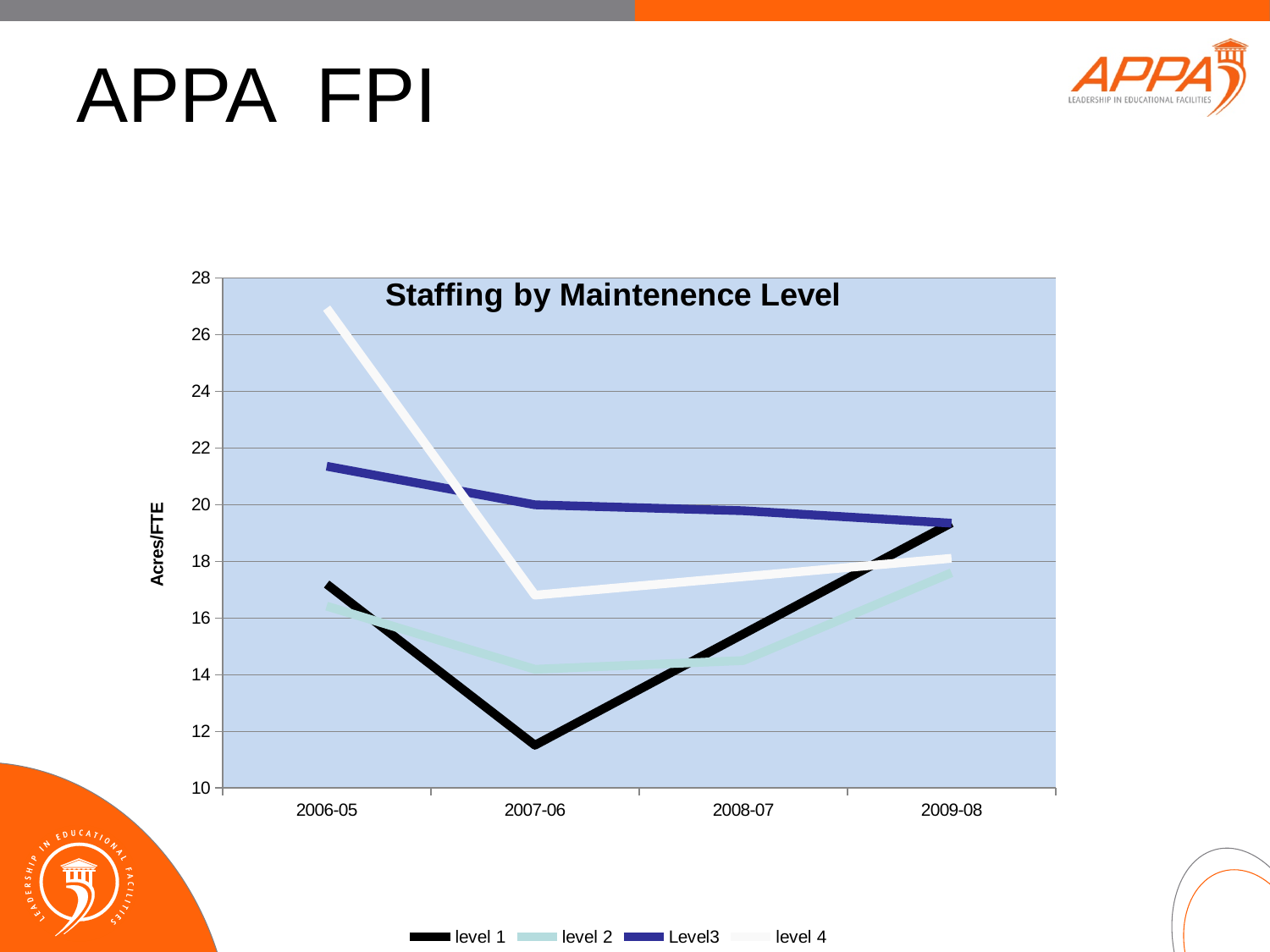
In 2008-07, which is larger: Level3 or level 2? Level3 What kind of chart is shown on the slide? line chart How many series does the legend of the 'Staffing by Maintenence Level' chart list? 4 Is the value for level 4 in 2006-05 greater or less than 24? greater How many years are shown on the x axis of the chart? 4 Which series has the lowest value in 2007-06? level 1 Is the value for level 1 in 2007-06 greater or less than 12? less Does the level 1 line rise or fall from 2007-06 to 2009-08? rise Is the value for Level3 in 2006-05 greater or less than 20? greater Which series has the highest value in 2006-05? level 4 What is the label on the y axis of the chart? Acres/FTE Does the Level3 line rise or fall from 2006-05 to 2009-08? fall